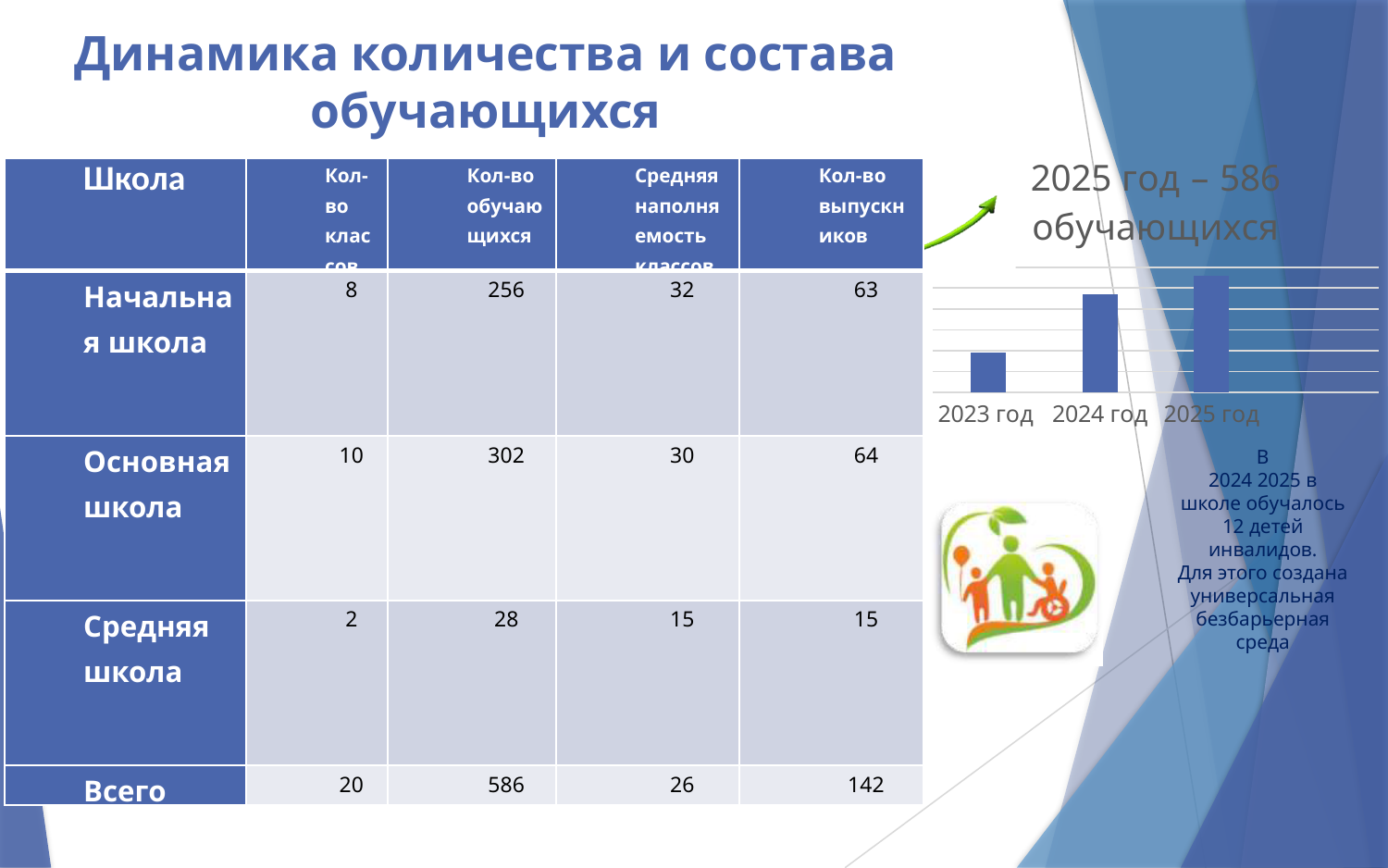
What kind of chart is shown on the right side of the slide? bar chart Which year has the shortest bar in the chart on the right side of the slide? 2023 год In the chart on the right side of the slide, which bar is taller: 2023 год or 2024 год? 2024 год Which year has the tallest bar in the chart on the right side of the slide? 2025 год How many bars does the chart on the right side of the slide have? 3 What colour are the bars in the chart on the right side of the slide? blue In the chart on the right side of the slide, which bar is taller: 2024 год or 2025 год? 2025 год What is the label of the leftmost bar in the chart on the right side of the slide? 2023 год Do the bar values rise or fall from 2023 год to 2025 год in the chart on the right side of the slide? rise